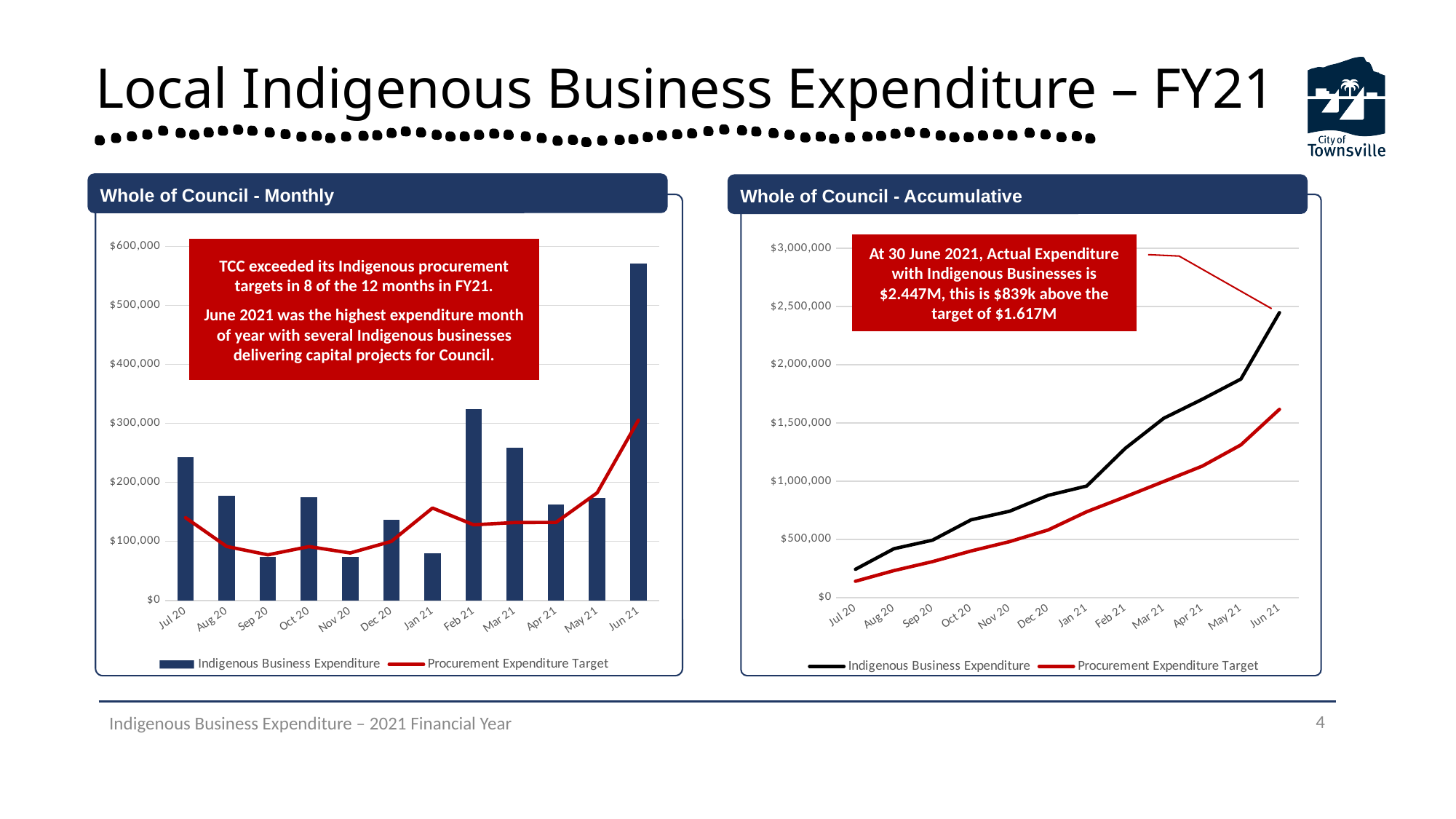
In the 'Whole of Council - Monthly' chart, which has the larger Indigenous Business Expenditure bar, Jul 20 or Aug 20? Jul 20 In the 'Whole of Council - Accumulative' chart, what colour is the Procurement Expenditure Target line? red In the 'Whole of Council - Accumulative' chart, is the Indigenous Business Expenditure value for Jun 21 greater or less than $2,000,000? greater In the 'Whole of Council - Monthly' chart, how many months are shown on the x axis? 12 In the 'Whole of Council - Monthly' chart, is the Indigenous Business Expenditure bar for Jun 21 greater or less than $500,000? greater How many series does the legend of the 'Whole of Council - Monthly' chart list? 2 In the 'Whole of Council - Monthly' chart, is the Indigenous Business Expenditure bar for Feb 21 greater or less than $300,000? greater In the 'Whole of Council - Monthly' chart, which has the larger Indigenous Business Expenditure bar, Feb 21 or Mar 21? Feb 21 In the 'Whole of Council - Monthly' chart, which month has the highest Indigenous Business Expenditure bar? Jun 21 What kind of chart is the 'Whole of Council - Accumulative' chart? line chart In the 'Whole of Council - Accumulative' chart, do the Indigenous Business Expenditure values rise or fall from Jul 20 to Jun 21? rise